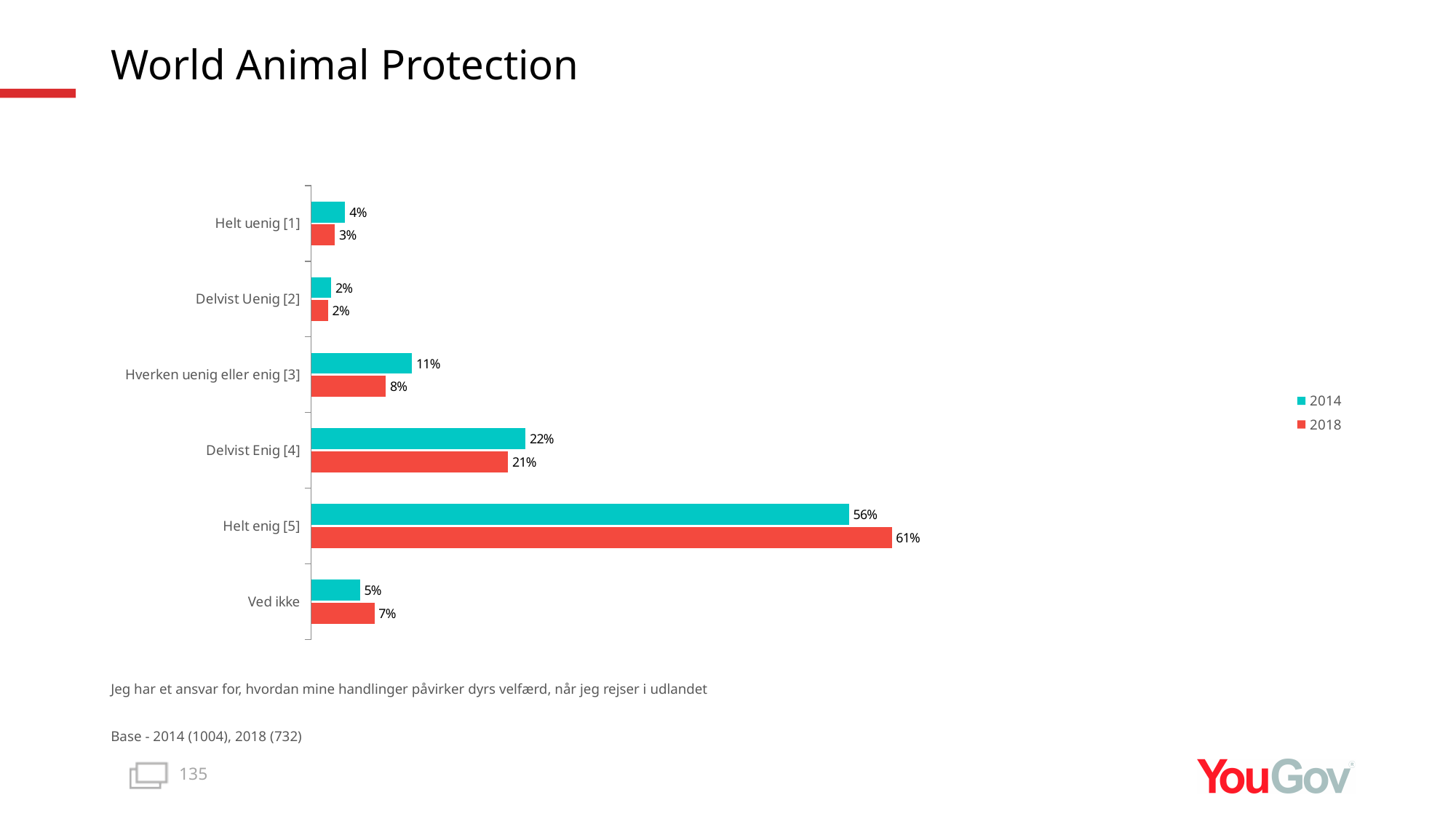
What is the difference between the 2018 and 2014 values for Helt enig [5]? 5% For Ved ikke, which year has the larger value, 2014 or 2018? 2018 How many categories are shown on the chart? 6 What is the 2018 value for Helt enig [5]? 61% What is the 2014 value for Hverken uenig eller enig [3]? 11% How many series does the legend list? 2 What kind of chart is shown on the slide? Bar chart Which category has the highest 2014 value? Helt enig [5] For Delvist Enig [4], which year has the larger value, 2014 or 2018? 2014 What is the difference between the 2014 and 2018 values for Hverken uenig eller enig [3]? 3% Which category has the lowest 2018 value? Delvist Uenig [2] What is the 2014 value for Ved ikke? 5%